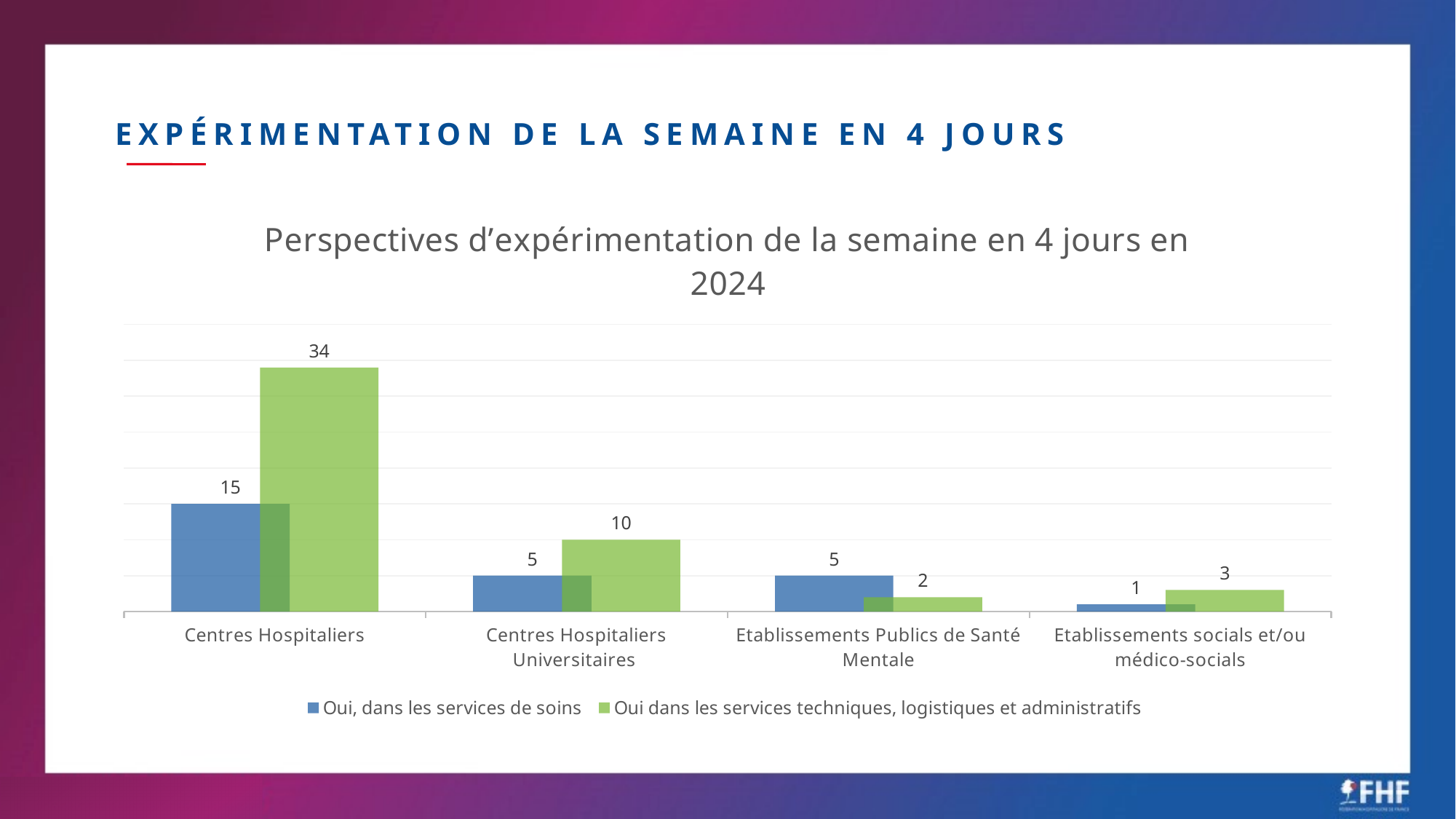
What is the title of the chart? Perspectives d'expérimentation de la semaine en 4 jours en 2024 What is the difference between the two series values for Centres Hospitaliers? 19 What is the value for 'Oui, dans les services de soins' for Centres Hospitaliers? 15 What is the value for 'Oui, dans les services de soins' for Etablissements socials et/ou médico-sociaux? 1 What is the value for 'Oui dans les services techniques, logistiques et administratifs' for Centres Hospitaliers Universitaires? 10 Which category has the highest value for 'Oui dans les services techniques, logistiques et administratifs'? Centres Hospitaliers What is the value for 'Oui dans les services techniques, logistiques et administratifs' for Centres Hospitaliers? 34 What kind of chart is shown on the slide? Bar chart For Etablissements Publics de Santé Mentale, which series has the larger value? Oui, dans les services de soins How many categories are shown on the x axis? 4 How many series does the legend list? 2 Which category has the lowest value for 'Oui, dans les services de soins'? Etablissements socials et/ou médico-socials